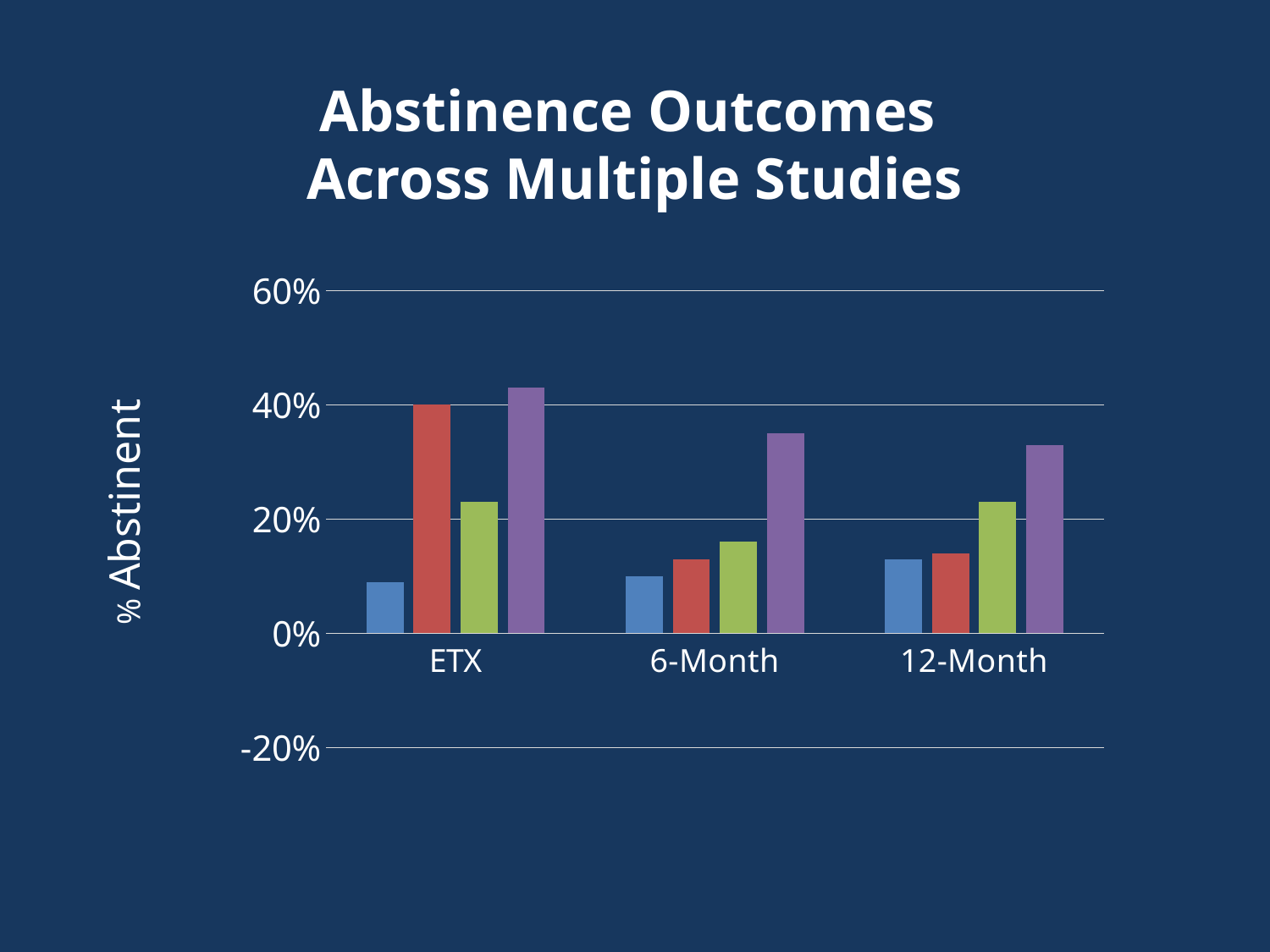
Is the value of the purple bar for ETX greater or less than 20%? greater What is the label on the vertical axis of the chart? % Abstinent Which bar is the tallest in the 6-Month group? the purple bar How many categories are shown on the x axis of the chart? 3 What is the title of the chart? Abstinence Outcomes Across Multiple Studies Is the value of the blue bar for ETX greater or less than 20%? less How many bars are plotted for each category on the chart? 4 In the 12-Month group, which is larger, the purple bar or the green bar? the purple bar Which bar is the shortest in the ETX group? the blue bar Is the value of the red bar for 12-Month greater or less than 20%? less What kind of chart is shown on the slide? bar chart